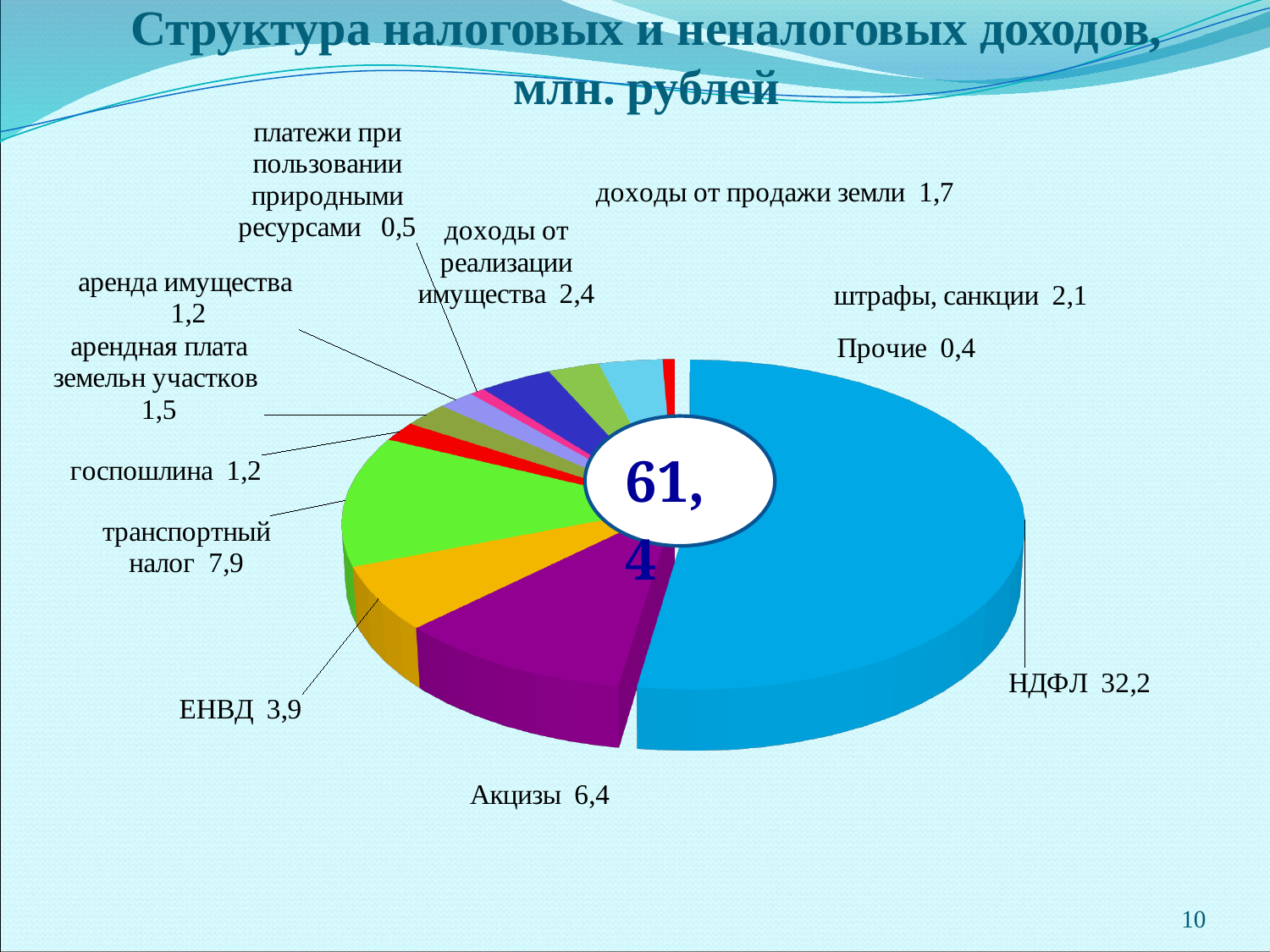
What is the value for доходы от реализации имущества? 2,4 What is the value for Акцизы? 6,4 What total value is printed in the centre of the pie chart? 61,4 What kind of chart is shown on the slide? pie chart What is the value for платежи при пользовании природными ресурсами? 0,5 Which category has the largest slice of the pie? НДФЛ Which category has the smallest value? Прочие How many categories are shown in the pie chart? 12 What is the difference between the values for НДФЛ and Акцизы? 25,8 What is the value for транспортный налог? 7,9 Which is larger, транспортный налог or ЕНВД? транспортный налог What is the value for НДФЛ? 32,2